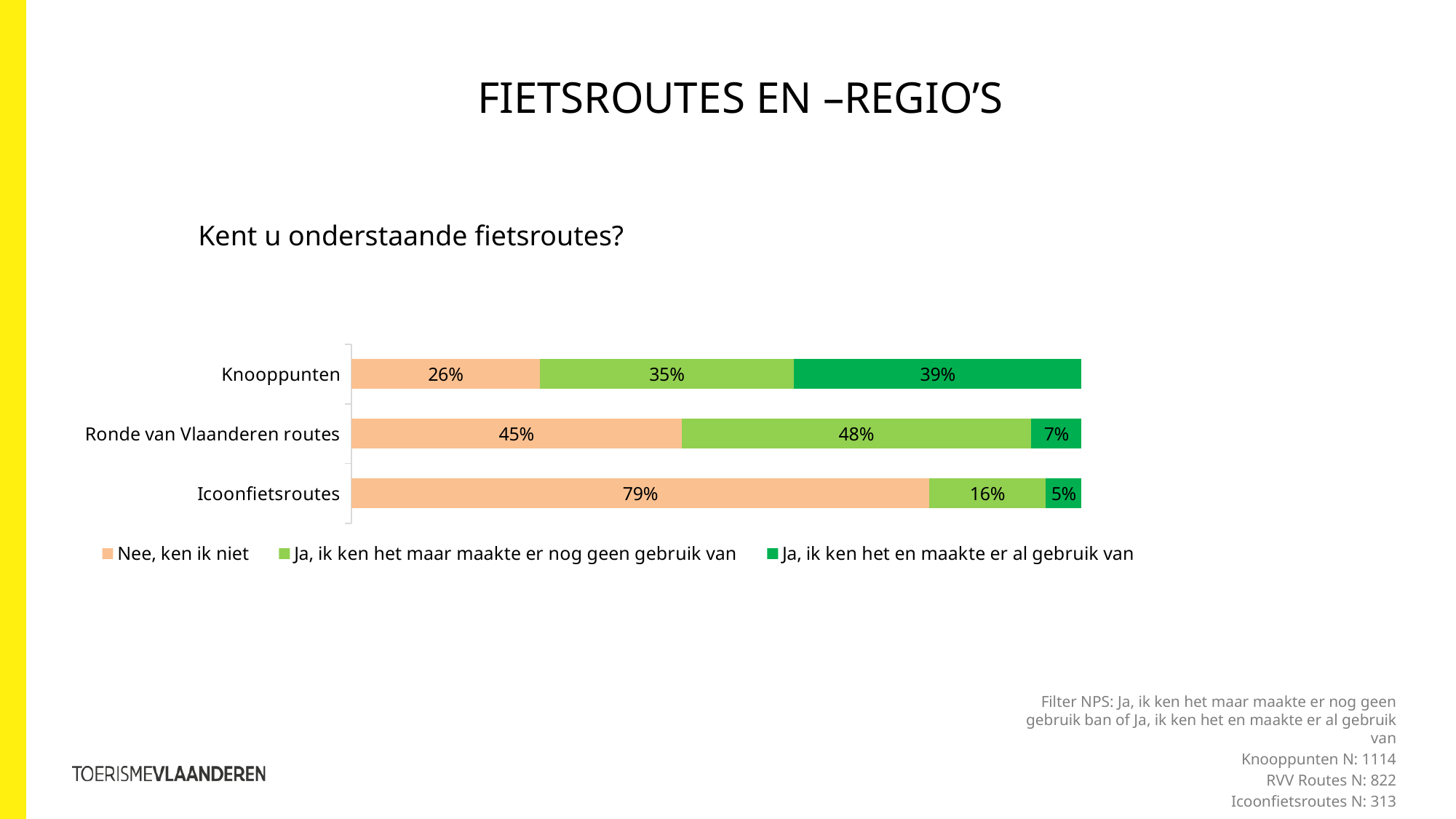
What question is the chart titled with? Kent u onderstaande fietsroutes? What percentage of respondents answered "Nee, ken ik niet" for Knooppunten? 26% What kind of chart is shown on the slide? Stacked bar chart Which route has the lowest share of "Ja, ik ken het en maakte er al gebruik van" responses? Icoonfietsroutes What percentage of respondents answered "Ja, ik ken het en maakte er al gebruik van" for Ronde van Vlaanderen routes? 7% How many routes (categories) are shown in the chart? 3 What percentage of respondents answered "Ja, ik ken het maar maakte er nog geen gebruik van" for Icoonfietsroutes? 16% What is the total of the three segments for the Knooppunten bar? 100% Which route has the highest share of "Nee, ken ik niet" responses? Icoonfietsroutes Which is larger: the "Ja, ik ken het maar maakte er nog geen gebruik van" share for Ronde van Vlaanderen routes or for Knooppunten? Ronde van Vlaanderen routes What is the difference between the "Nee, ken ik niet" share for Icoonfietsroutes and for Knooppunten? 53 percentage points How many series does the legend list? 3